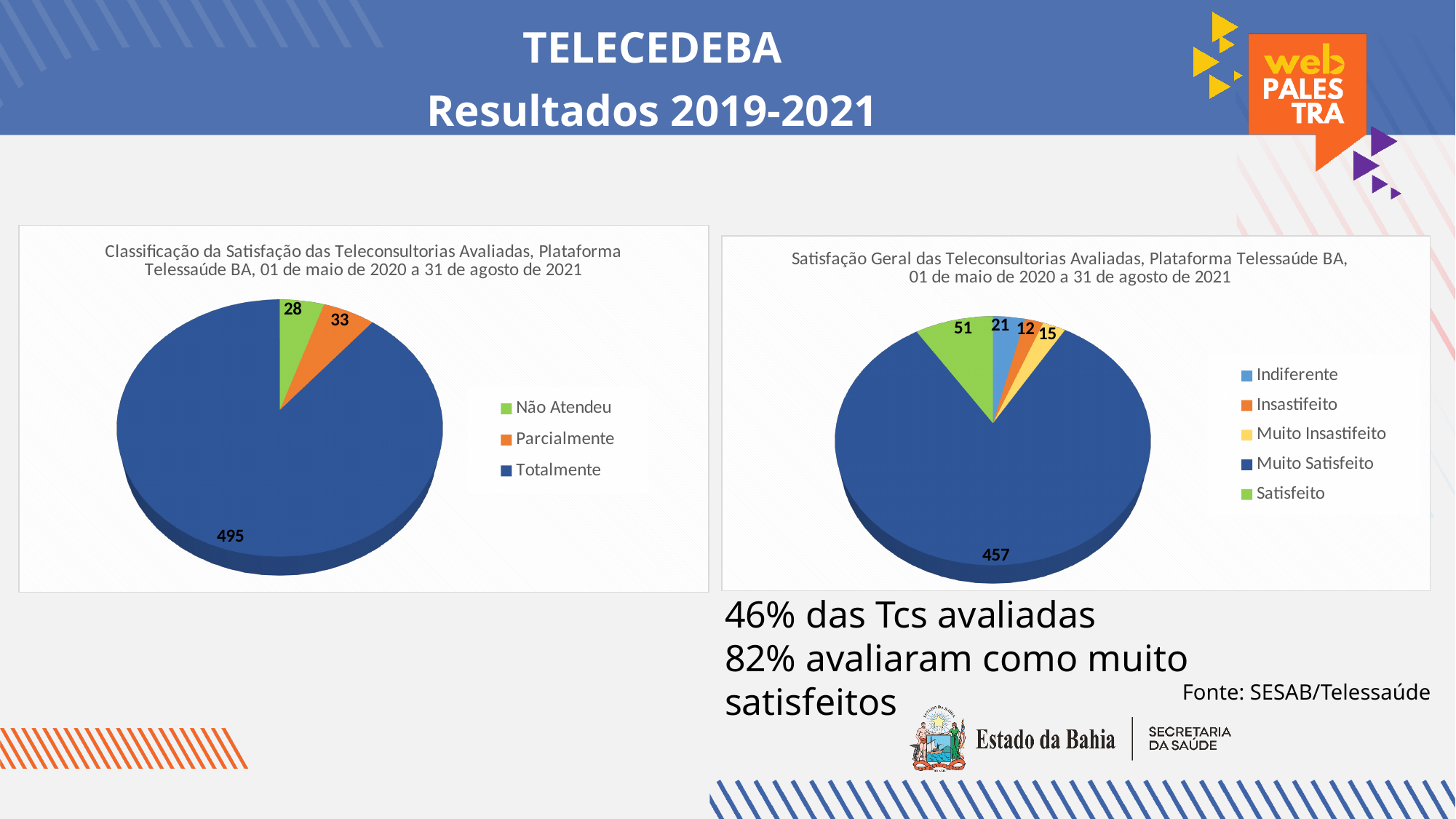
In the left chart, what is the difference between 'Parcialmente' and 'Não Atendeu'? 5 In the right chart, which category has the smallest value? Insastifeito In the right chart, what is the value for 'Indiferente'? 21 How many categories does the legend of the right chart list? 5 In the right chart, 'Satisfação Geral das Teleconsultorias Avaliadas', what is the value for 'Muito Satisfeito'? 457 In the left chart, what is the value for 'Totalmente'? 495 In the left chart, what is the value for 'Não Atendeu'? 28 In the right chart, what is the difference between 'Muito Satisfeito' and 'Satisfeito'? 406 In the left chart, which category has the smallest value? Não Atendeu How many categories does the legend of the left chart list? 3 What type of chart is the left chart, 'Classificação da Satisfação das Teleconsultorias Avaliadas'? Pie chart In the right chart, which is larger: 'Satisfeito' or 'Indiferente'? Satisfeito